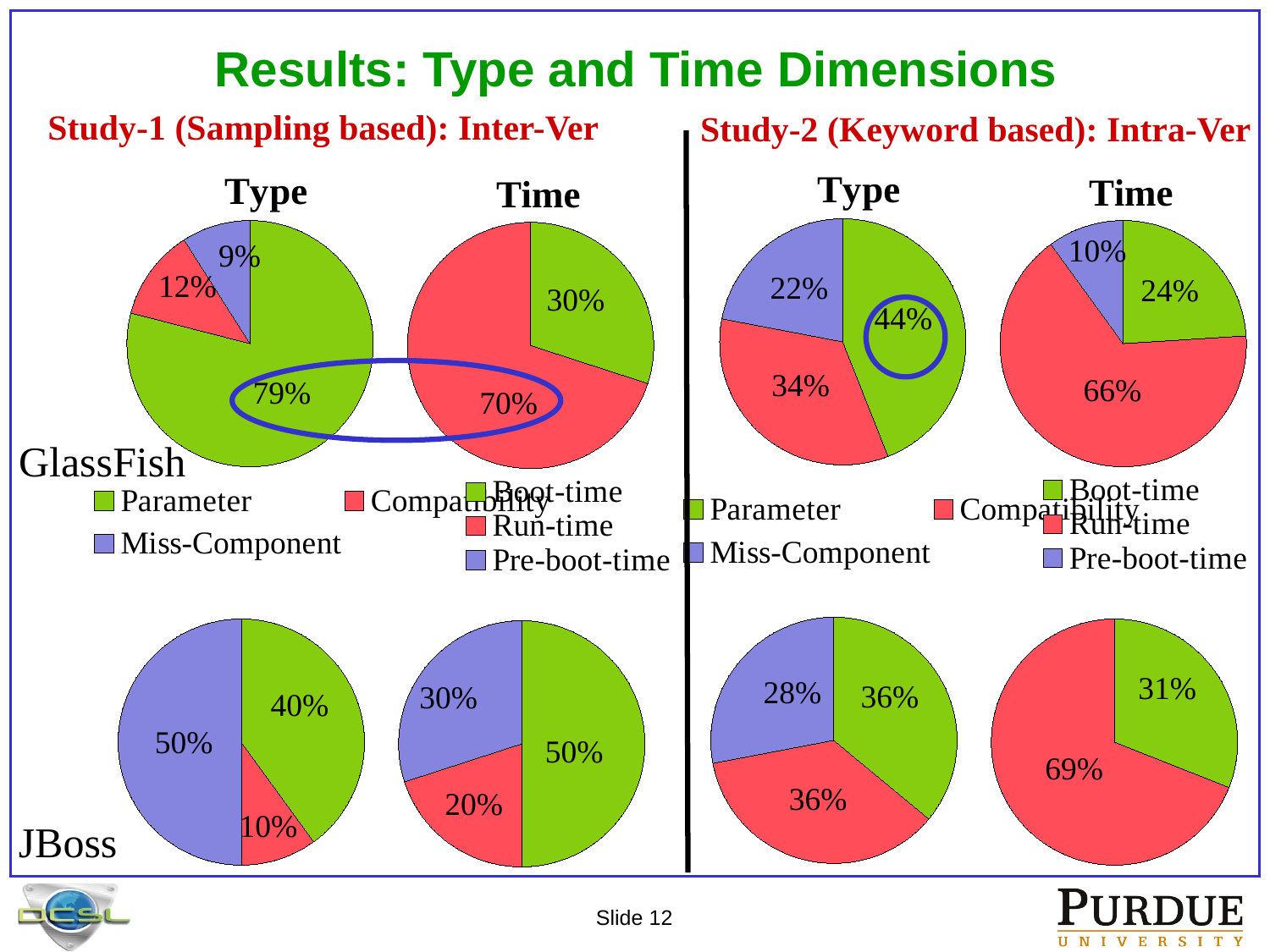
How many categories does the Type legend list? 3 In the Study-2 GlassFish Type pie chart, what share is Parameter? 44% In the Study-2 JBoss Type pie chart, what share is Miss-Component? 28% In the Study-1 JBoss Time pie chart, what share is Pre-boot-time? 30% In the Study-1 GlassFish Time pie chart, what share is Run-time? 70% In the Study-2 GlassFish Time pie chart, what is the difference between the Run-time and Boot-time shares? 42% In the Study-1 GlassFish Type pie chart, what share is Parameter? 79% What kind of charts are shown on the slide? Pie charts In the Study-2 JBoss Time pie chart, which is larger, Run-time or Boot-time? Run-time In the Study-1 JBoss Type pie chart, which category has the largest share? Miss-Component In the Study-2 GlassFish Time pie chart, which category has the smallest share? Pre-boot-time In the Study-1 JBoss Type pie chart, which category has the smallest share? Compatibility